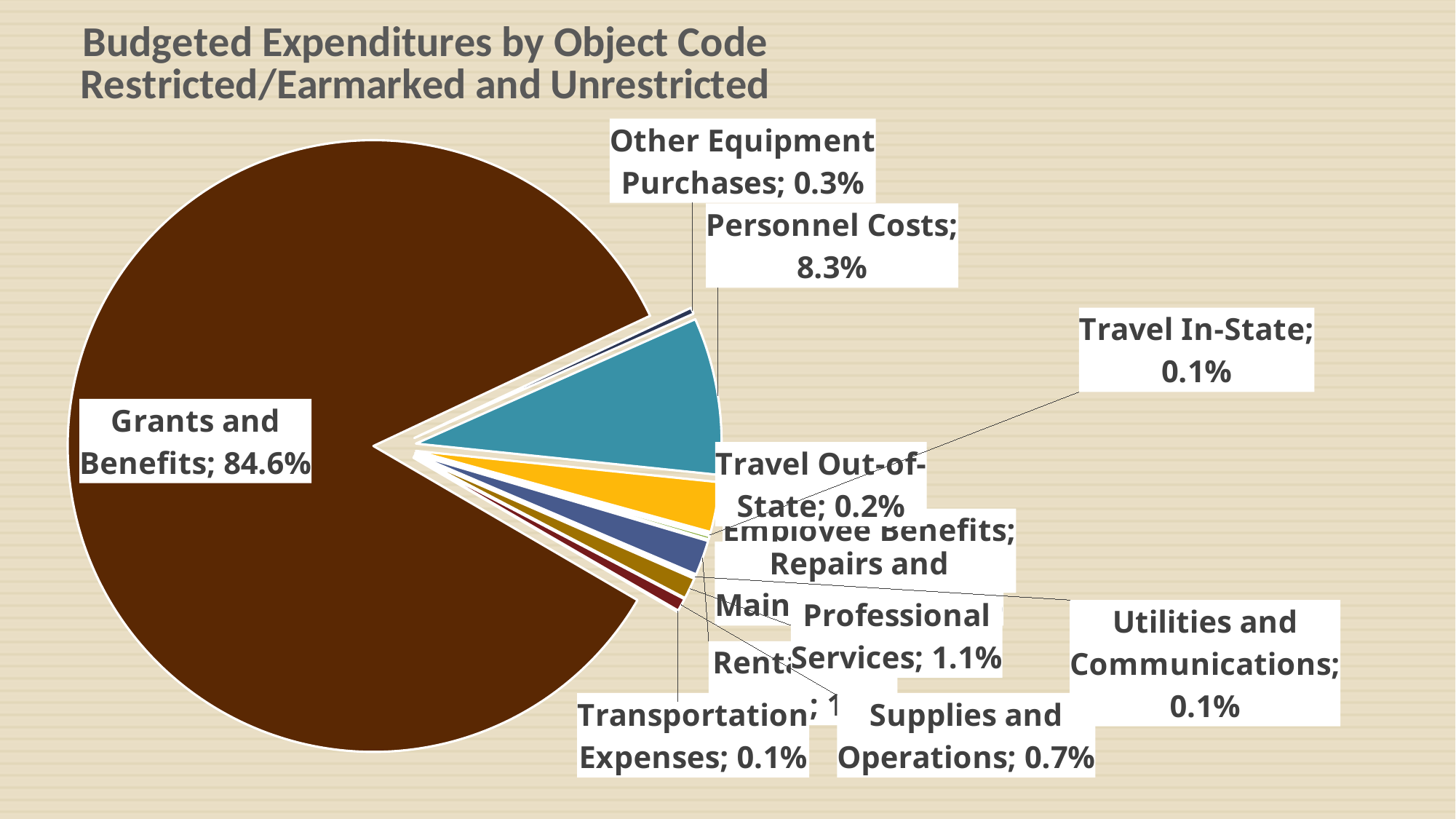
Which is larger, Personnel Costs or Professional Services? Personnel Costs What is the value shown for Supplies and Operations? 0.7% What is the value shown for Professional Services? 1.1% What is the value shown for Travel Out-of-State? 0.2% What is the difference between the shares for Grants and Benefits and Personnel Costs? 76.3% What is the value shown for Utilities and Communications? 0.1% What type of chart is shown on the slide? pie chart What share of budgeted expenditures is Grants and Benefits? 84.6% Which category has the largest share of the pie? Grants and Benefits What is the value shown for Other Equipment Purchases? 0.3% What is the value shown for Personnel Costs? 8.3% What is the title of the chart? Budgeted Expenditures by Object Code Restricted/Earmarked and Unrestricted